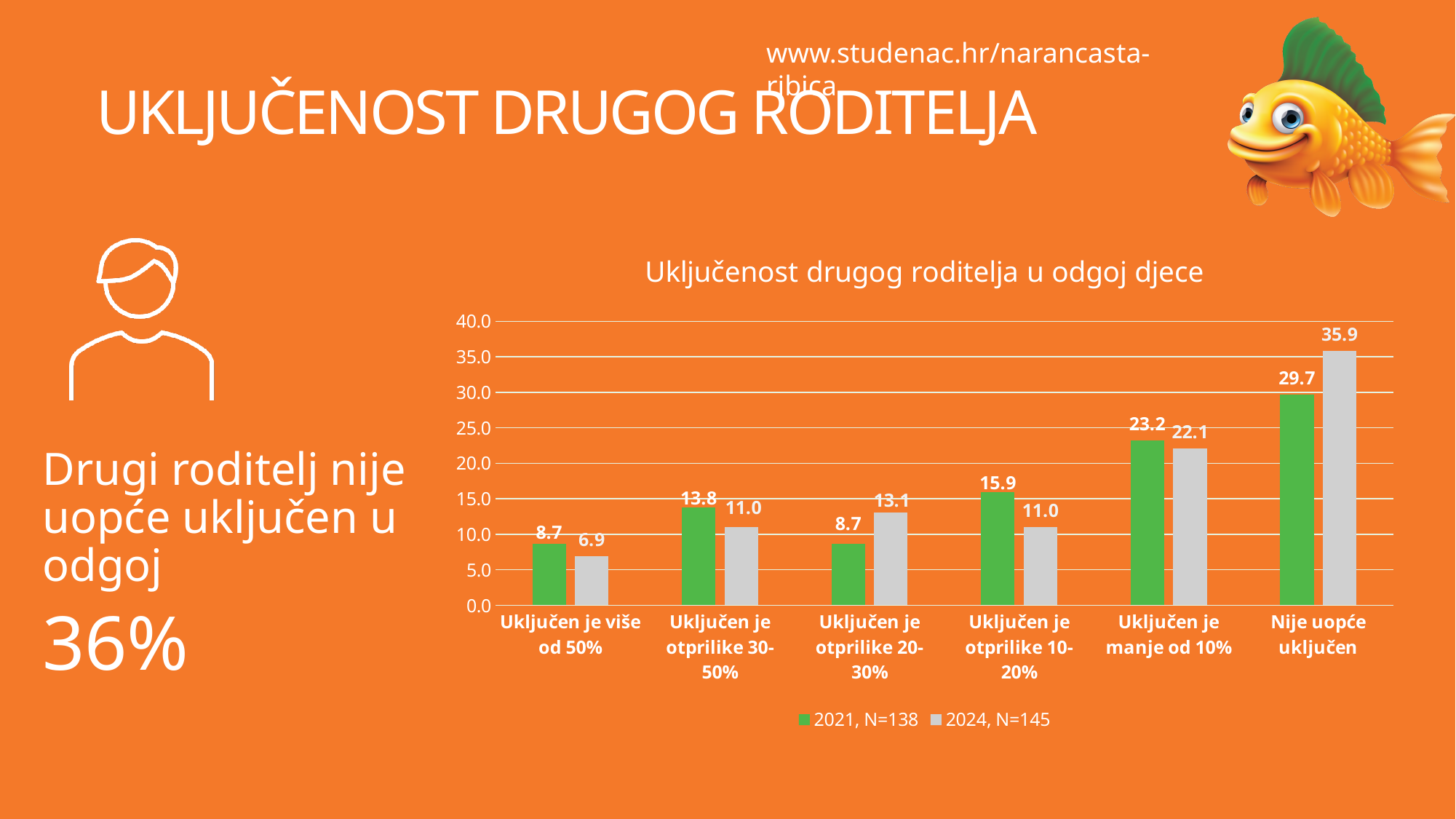
How many series does the legend list? 2 Which category has the highest 2024, N=145 value? Nije uopće uključen Which is larger for "Uključen je otprilike 20-30%": the 2021, N=138 value or the 2024, N=145 value? 2024, N=145 What kind of chart is shown on the slide? bar chart What is the difference between the 2024, N=145 and 2021, N=138 values for "Nije uopće uključen"? 6.2 Which category has the lowest 2024, N=145 value? Uključen je više od 50% What is the title of the chart? Uključenost drugog roditelja u odgoj djece What is the 2021, N=138 value for "Uključen je otprilike 10-20%"? 15.9 What is the 2024, N=145 value for "Uključen je otprilike 20-30%"? 13.1 Is the 2021, N=138 value for "Uključen je manje od 10%" greater or less than 20.0? greater How many categories are shown on the x axis? 6 What is the 2021, N=138 value for "Nije uopće uključen"? 29.7